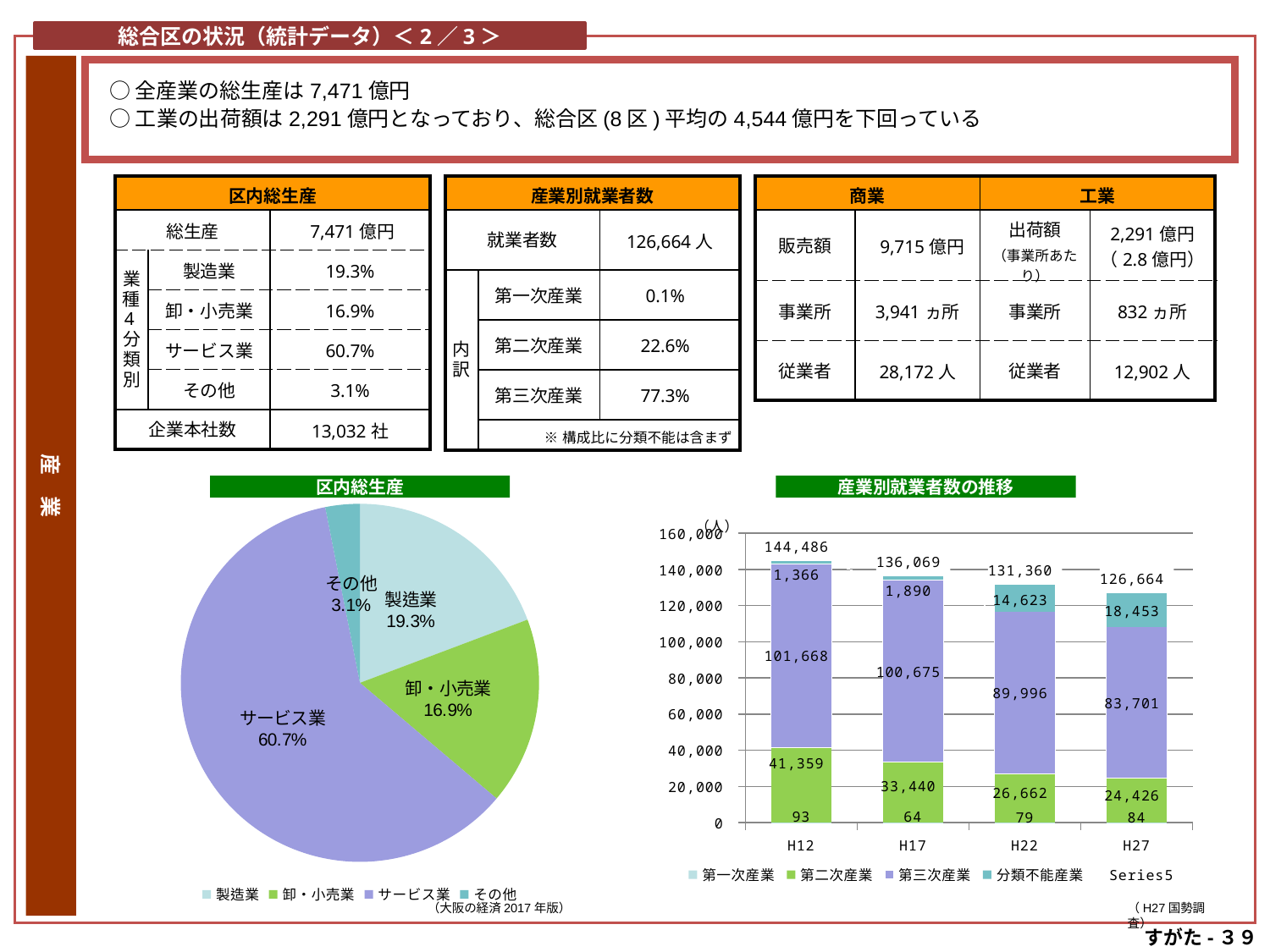
In the pie chart titled 区内総生産, which category has the smallest share? その他 In the pie chart titled 区内総生産, how many slices are there? 4 In the bar chart titled 産業別就業者数の推移, which is larger: 分類不能産業 in H22 or in H27? H27 In the bar chart titled 産業別就業者数の推移, what is the total for H27? 126,664 In the bar chart titled 産業別就業者数の推移, which year has the highest total? H12 In the bar chart titled 産業別就業者数の推移, what is the value for 第三次産業 in H22? 89,996 In the pie chart titled 区内総生産, what share does サービス業 have? 60.7% In the bar chart titled 産業別就業者数の推移, what is the difference between the 第二次産業 values for H12 and H27? 16,933 In the pie chart titled 区内総生産, what is the difference in percentage points between 製造業 and 卸・小売業? 2.4 In the bar chart titled 産業別就業者数の推移, do the totals rise or fall from H12 to H27? fall What kind of chart is the chart titled 産業別就業者数の推移? stacked bar chart How many entries does the legend of the chart titled 産業別就業者数の推移 list? 5